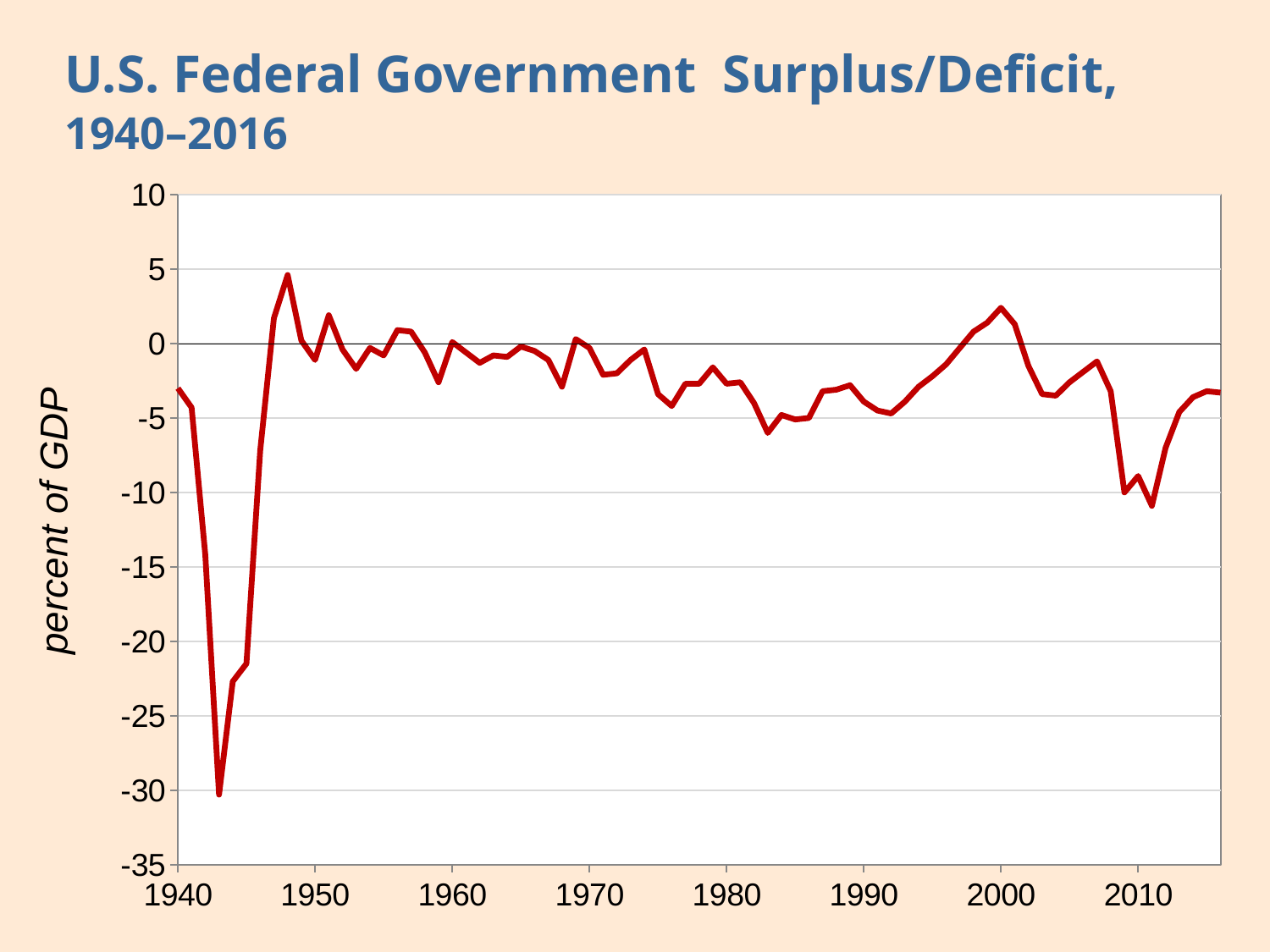
What kind of chart is shown on the slide? line chart Does the line rise or fall between 2000 and 2009? fall Is the lowest value on the chart greater or less than -25? less Is the value around 2000 greater or less than 0? greater Is the value around 1992 greater or less than 0? less In which decade does the line reach its highest point? 1940s What is the label on the vertical axis? percent of GDP Does the line rise or fall between 2011 and 2016? rise What is the title of the chart? U.S. Federal Government Surplus/Deficit, 1940–2016 In which decade does the line reach its lowest point? 1940s Which is larger, the peak value in the late 1940s or the peak value around 2000? the peak in the late 1940s